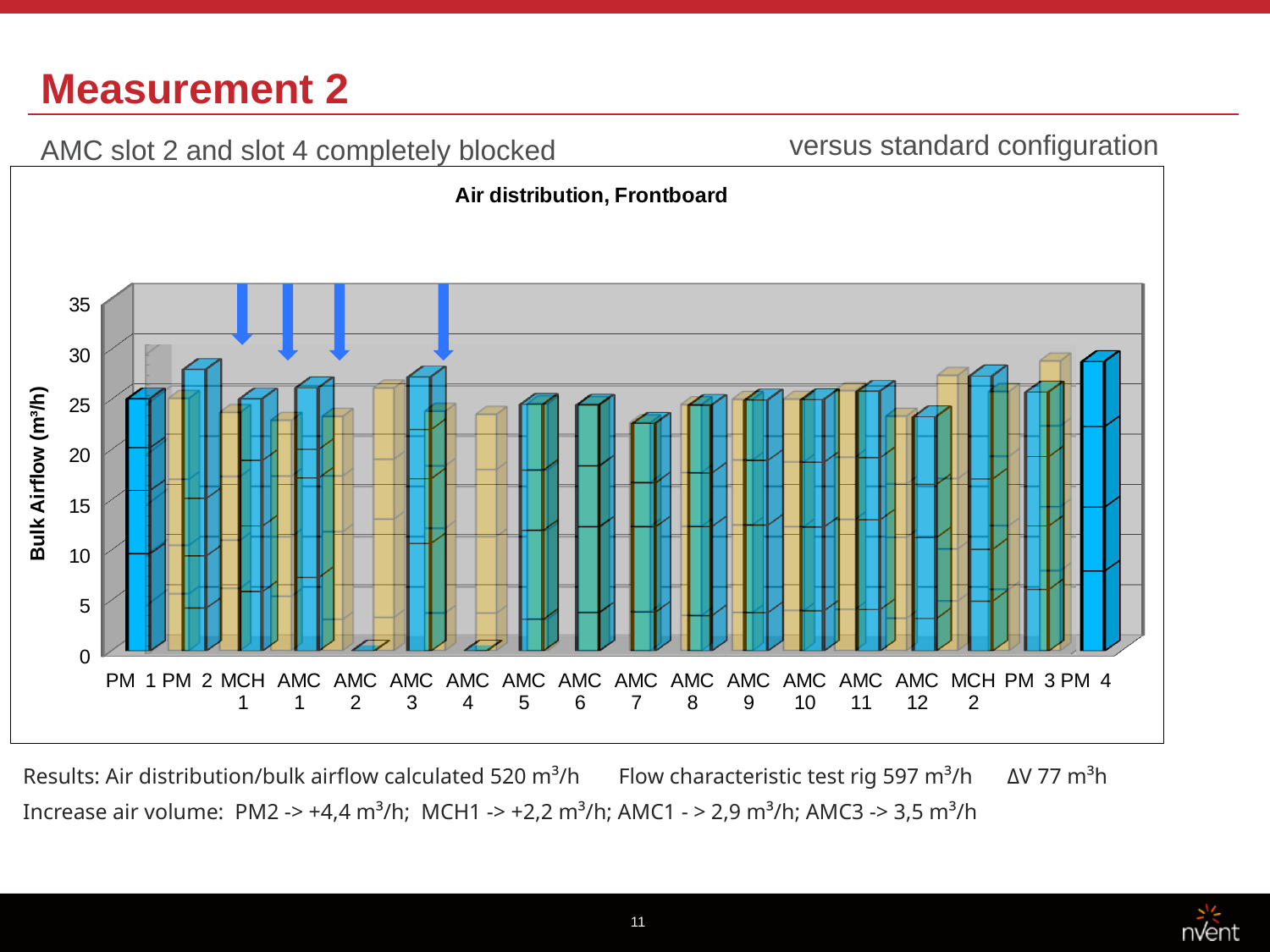
Is the blue bar for AMC 4 greater or less than 5? less Is the blue bar for PM 2 greater or less than 25? greater Which has the larger blue bar, AMC 2 or AMC 3? AMC 3 What kind of chart is shown on the slide? bar chart How many categories are shown along the x axis of the chart? 18 What is the label of the vertical axis of the chart? Bulk Airflow (m³/h) Is the blue bar for AMC 3 greater or less than 25? greater What is the title of the chart? Air distribution, Frontboard What is the highest value shown on the vertical axis of the chart? 35 Which has the larger blue bar, PM 1 or PM 4? PM 4